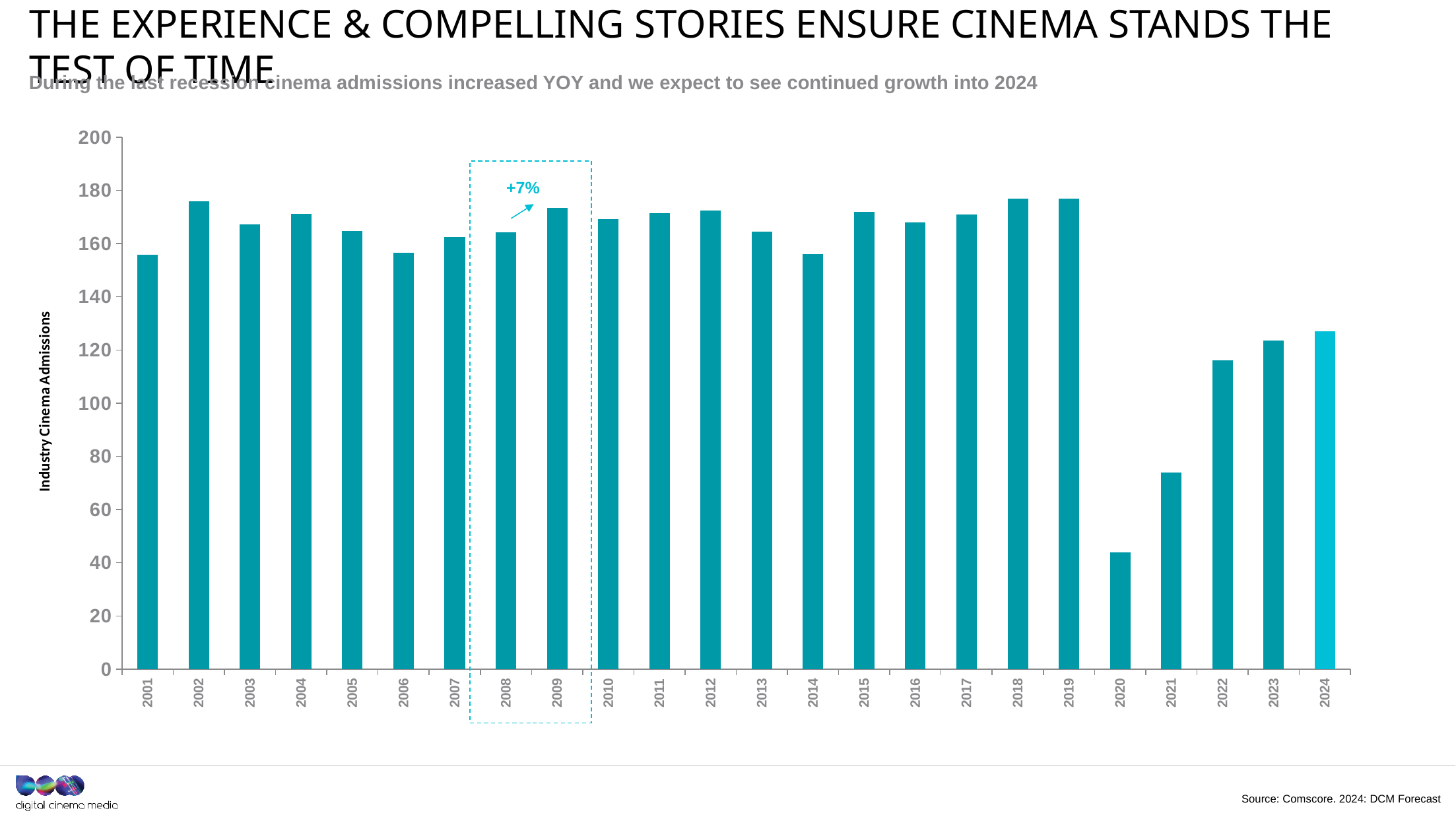
Is the value for 2024 greater or less than 120? greater What kind of chart is shown on the slide? bar chart Is the value for 2001 greater or less than 160? less What percentage change is annotated between 2008 and 2009? +7% Which year has the lowest industry cinema admissions? 2020 How many years (bars) are plotted on the chart? 24 Do the values rise or fall from 2020 to 2024? rise Is the value for 2002 greater or less than 160? greater What is the label on the vertical axis? Industry Cinema Admissions Which is larger, the value for 2014 or the value for 2015? 2015